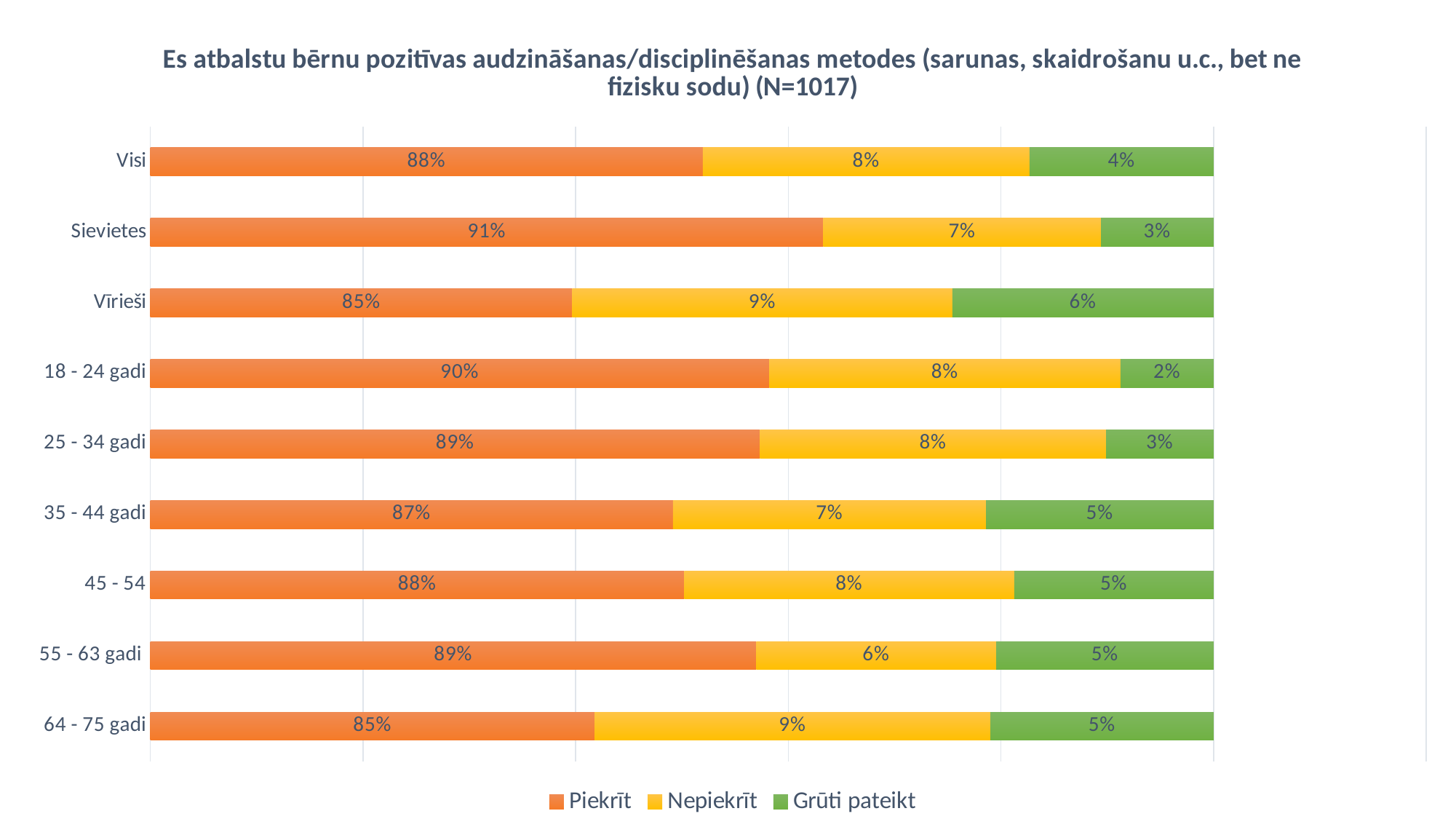
What is the Piekrīt value for Sievietes? 91% Which category has the highest Grūti pateikt value? Vīrieši Which category has the lowest Grūti pateikt value? 18 - 24 gadi What kind of chart is shown on the slide? Stacked bar chart How many categories are plotted on the chart? 9 What is the total of the stacked bar for Visi? 100% What is the difference between the Piekrīt values for Sievietes and Vīrieši? 6 percentage points How many series does the legend list? 3 Which category has the highest Piekrīt value? Sievietes Which is larger, the Piekrīt value for 18 - 24 gadi or for 35 - 44 gadi? 18 - 24 gadi What is the Nepiekrīt value for 55 - 63 gadi? 6% What is the Grūti pateikt value for Vīrieši? 6%